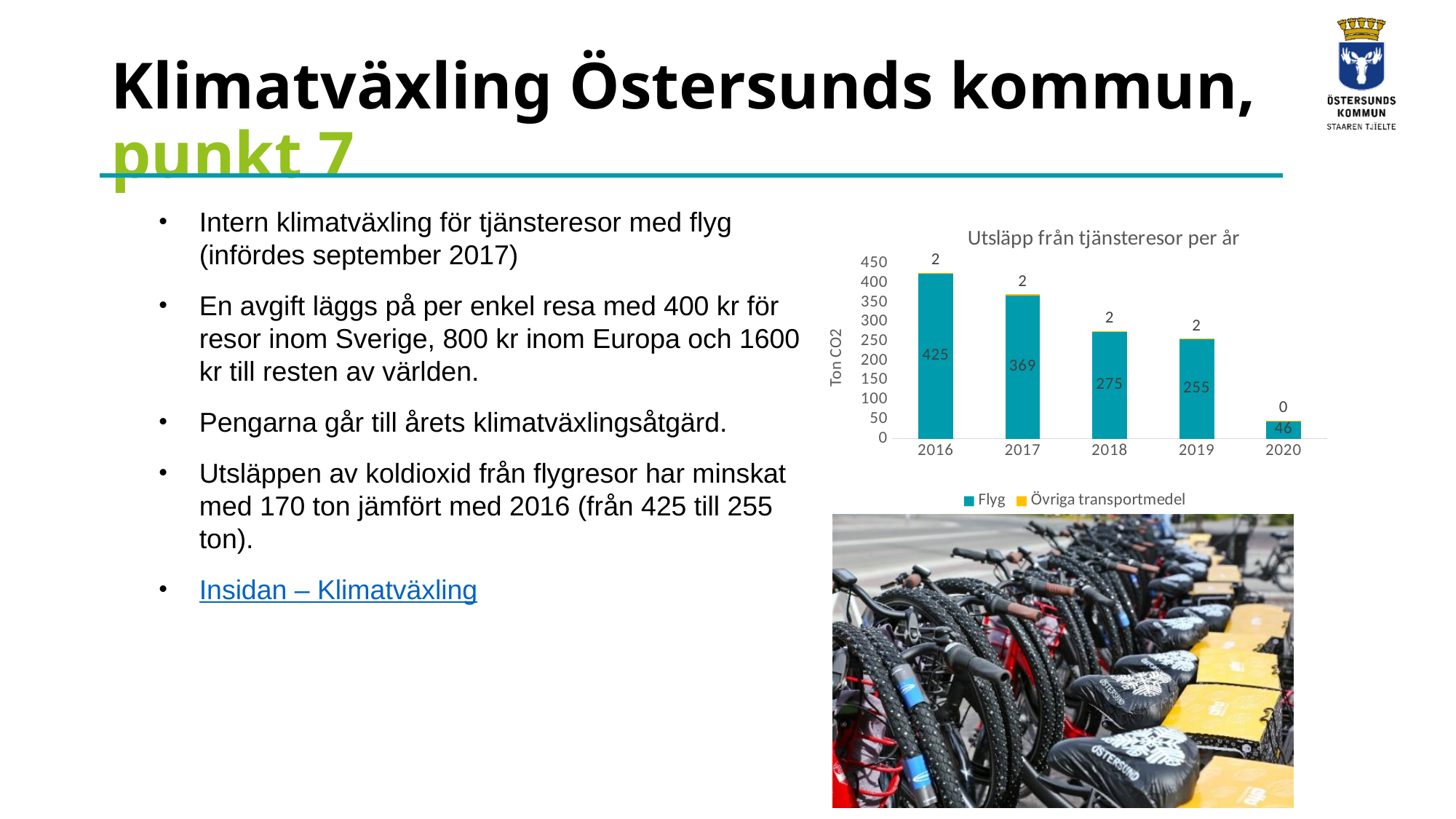
What is the difference between the Flyg values for 2016 and 2019? 170 Which year has the highest Flyg value? 2016 Which is larger, the Flyg value for 2017 or for 2018? 2017 Which year has the lowest Flyg value? 2020 Do the Flyg values rise or fall from 2016 to 2020? Fall How many series does the legend list? 2 What is the Övriga transportmedel value for 2018? 2 What is the Flyg value for 2016? 425 How many years are shown on the x axis? 5 What kind of chart is shown? Bar chart What is the Flyg value for 2020? 46 What is the title of the chart? Utsläpp från tjänsteresor per år